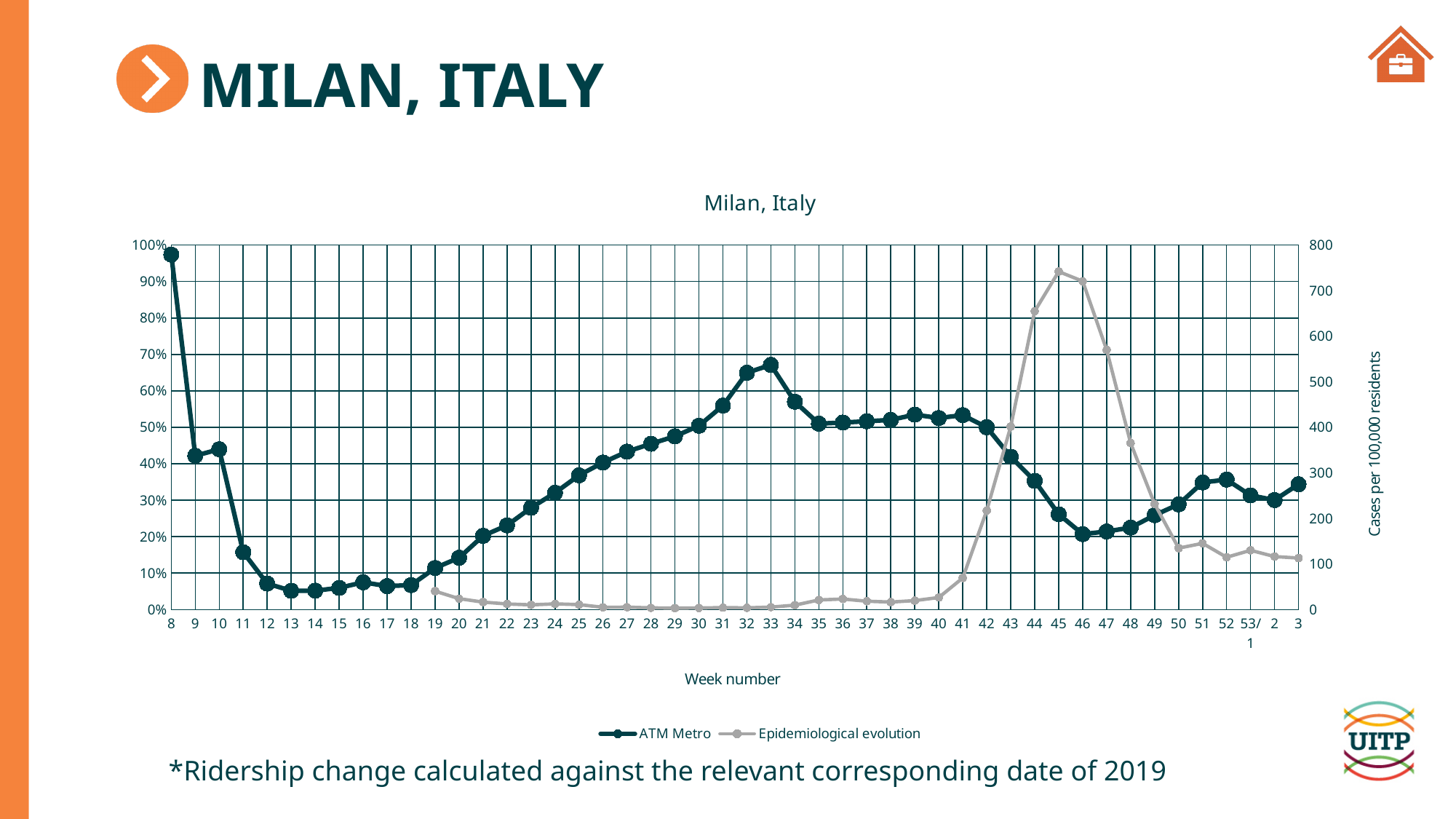
How many series does the legend list? 2 What is the title of the right-hand vertical axis? Cases per 100,000 residents What kind of chart is shown on the slide? line chart Is the Epidemiological evolution value at week 44 greater or less than 600? greater At which week number does the Epidemiological evolution series reach its highest value? 45 What are the two series named in the legend? ATM Metro and Epidemiological evolution Which is larger for ATM Metro: the value at week 33 or the value at week 9? week 33 Is the ATM Metro value at week 11 greater or less than 20%? less At which week number does the ATM Metro series reach its highest value? 8 Does the ATM Metro series rise or fall between week 19 and week 33? rise Is the ATM Metro value at week 33 greater or less than 60%? greater